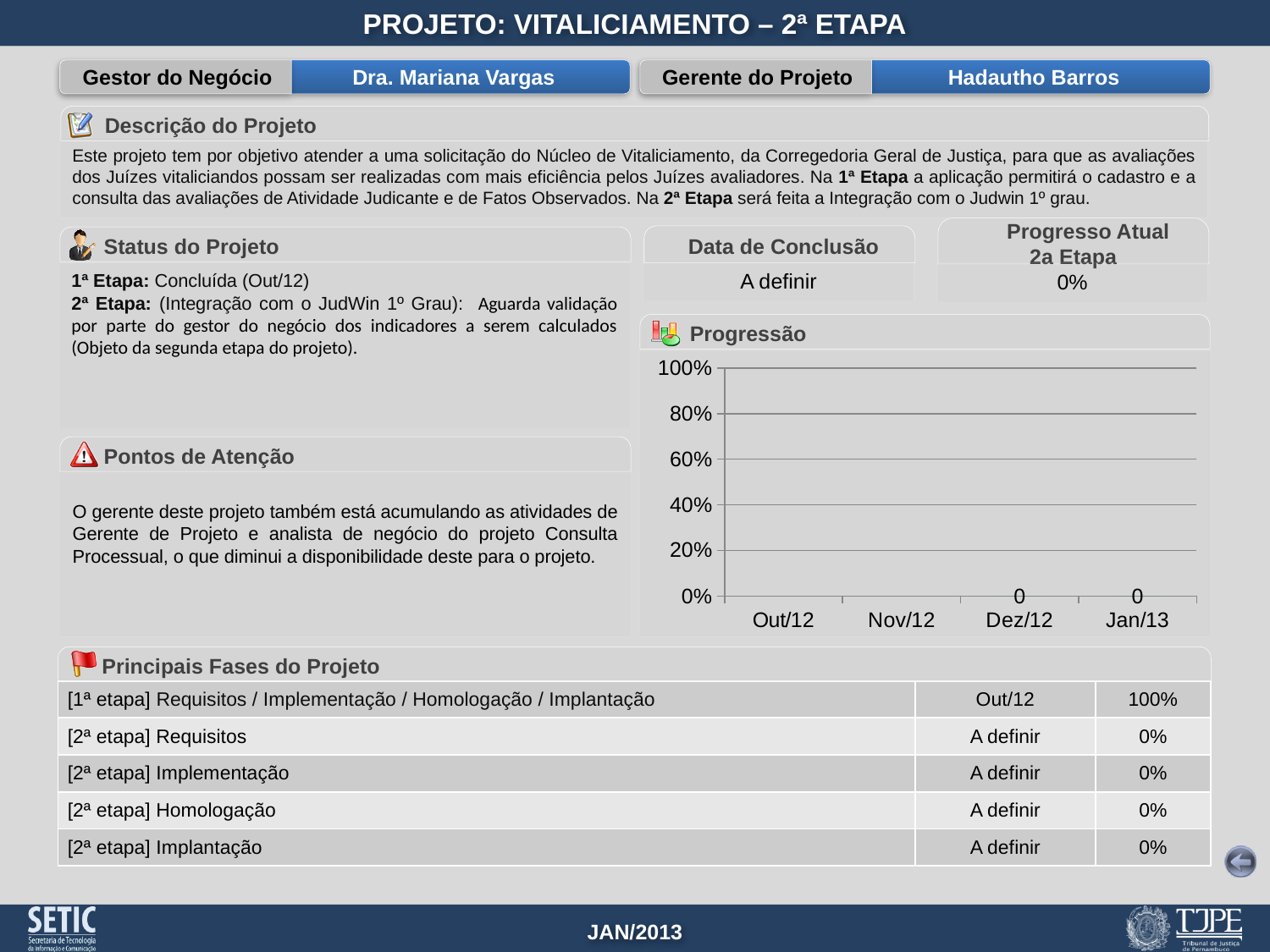
In the Progressão chart, what is the lowest value shown on the y axis? 0% In the Progressão chart, how many categories are shown on the x axis? 4 In the Progressão chart, what is the highest value shown on the y axis? 100% In the Progressão chart, is the value for Jan/13 greater or less than 40%? less In the Progressão chart, is the value for Dez/12 greater or less than 20%? less In the Progressão chart, what value is labelled for Dez/12? 0 In the Progressão chart, what value is labelled for Jan/13? 0 In the Progressão chart, what is the first category on the x axis? Out/12 What is the title of the chart on the slide? Progressão